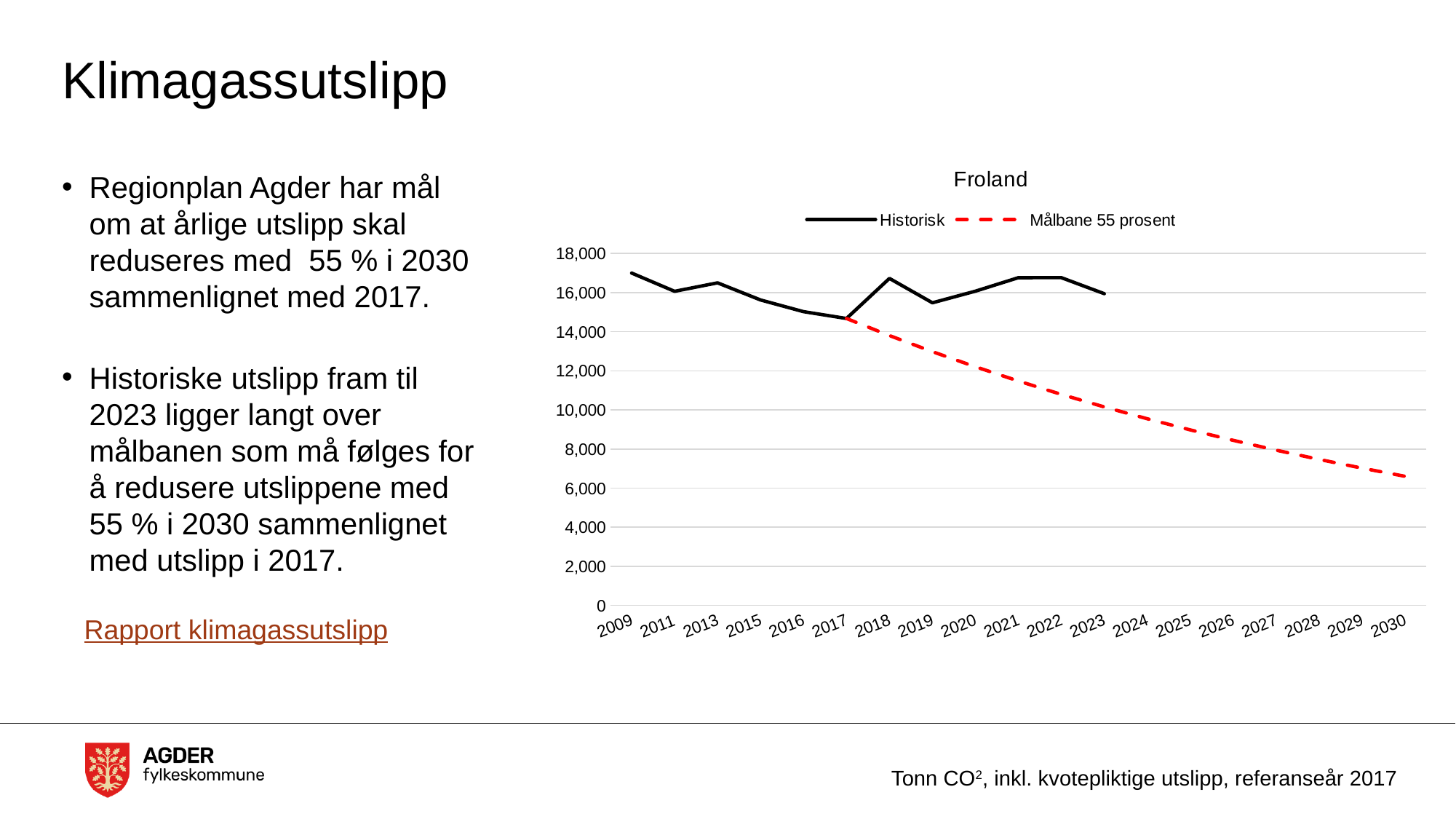
Is the Målbane 55 prosent value for 2027 greater or less than 10,000? less In which year does the Historisk series reach its lowest value? 2017 Is the Historisk value for 2017 greater or less than 16,000? less What kind of chart is shown on the slide? line chart Is the Målbane 55 prosent value for 2030 greater or less than 8,000? less What is the title of the chart? Froland How many series does the chart legend list? 2 Which series is drawn as a red dashed line? Målbane 55 prosent How many years are labelled on the x axis of the chart? 19 Does the Målbane 55 prosent series rise or fall from 2017 to 2030? fall